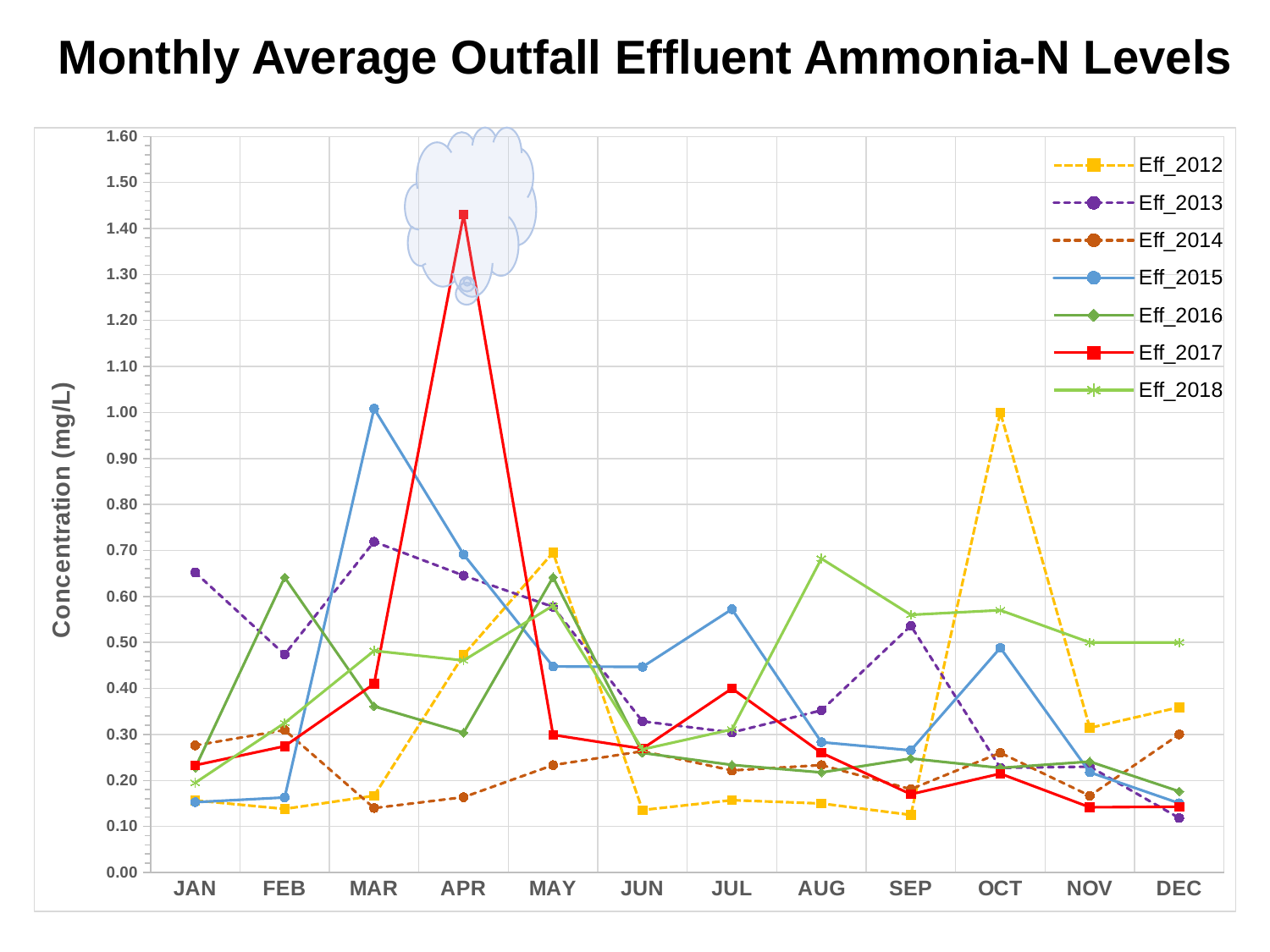
Is the value for Eff_2017 in APR greater or less than 1.30? greater Which series contains the single highest value on the chart? Eff_2017 Does the Eff_2017 line rise or fall from APR to MAY? fall In which month does Eff_2017 reach its highest value? APR What kind of chart is shown on the slide? line chart In MAR, which is larger: Eff_2015 or Eff_2014? Eff_2015 Is the value for Eff_2015 in MAR greater or less than 0.90? greater Is the value for Eff_2014 in MAR greater or less than 0.20? less What is the title of the y axis? Concentration (mg/L) How many months are shown along the x axis? 12 In which month does Eff_2012 reach its highest value? OCT How many series does the legend list? 7